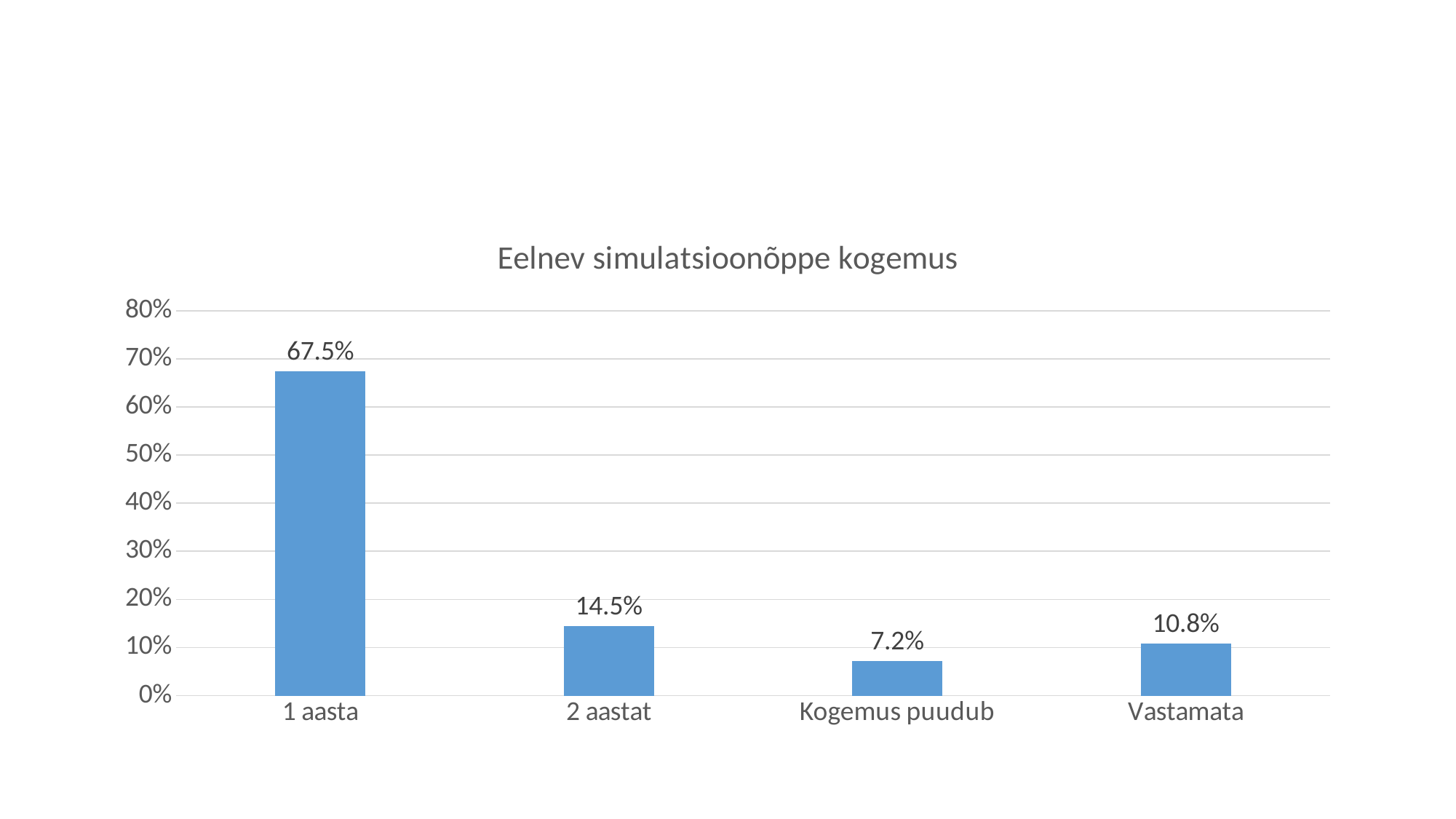
What is the value for "1 aasta"? 67.5% Which is larger, the value for "2 aastat" or the value for "Vastamata"? 2 aastat What is the difference between the values for "1 aasta" and "2 aastat"? 53.0% Which category has the highest value? 1 aasta What is the value for "Kogemus puudub"? 7.2% Which category has the lowest value? Kogemus puudub How many categories are shown on the x axis? 4 What is the value for "Vastamata"? 10.8% Is the value for "1 aasta" greater or less than 60%? greater What is the title of the chart? Eelnev simulatsioonõppe kogemus What is the value for "2 aastat"? 14.5% What is the difference between the values for "Vastamata" and "Kogemus puudub"? 3.6%